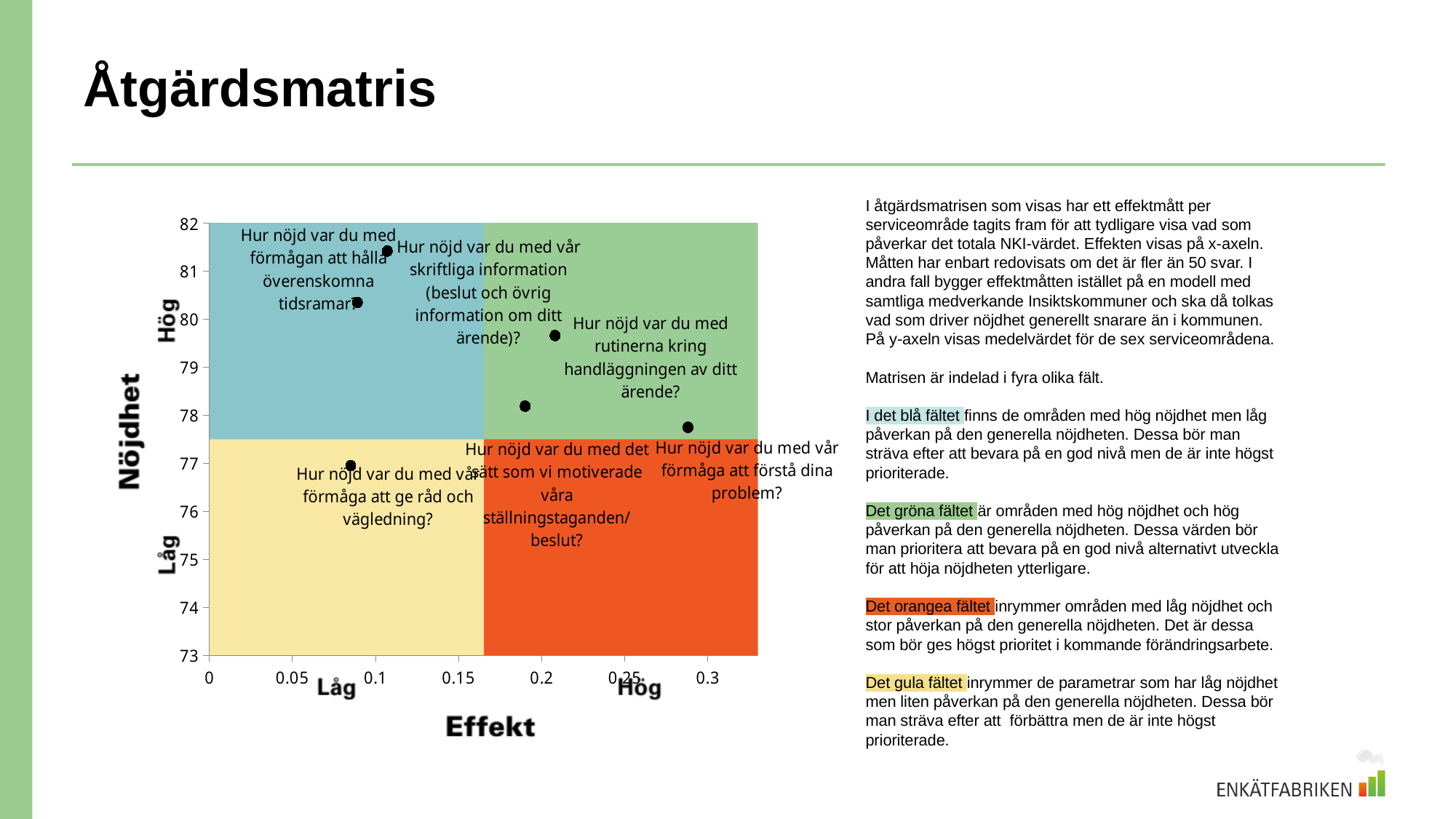
Is the Nöjdhet value for 'Hur nöjd var du med vår förmåga att ge råd och vägledning?' greater or less than 78? less How many data points are plotted in the chart? 6 Which has the higher Nöjdhet value: 'Hur nöjd var du med rutinerna kring handläggningen av ditt ärende?' or 'Hur nöjd var du med vår förmåga att förstå dina problem?' Hur nöjd var du med rutinerna kring handläggningen av ditt ärende? Is the Effekt value for 'Hur nöjd var du med vår förmåga att förstå dina problem?' greater or less than 0.25? greater What kind of chart is shown on the slide? scatter chart What is the title of the x axis of the chart? Effekt Which point has the highest Effekt value in the chart? Hur nöjd var du med vår förmåga att förstå dina problem? Is the Nöjdhet value for 'Hur nöjd var du med rutinerna kring handläggningen av ditt ärende?' greater or less than 79? greater What is the title of the y axis of the chart? Nöjdhet Which has the higher Effekt value: 'Hur nöjd var du med vår förmåga att förstå dina problem?' or 'Hur nöjd var du med vår förmåga att ge råd och vägledning?' Hur nöjd var du med vår förmåga att förstå dina problem? Which point has the lowest Nöjdhet value in the chart? Hur nöjd var du med vår förmåga att ge råd och vägledning?